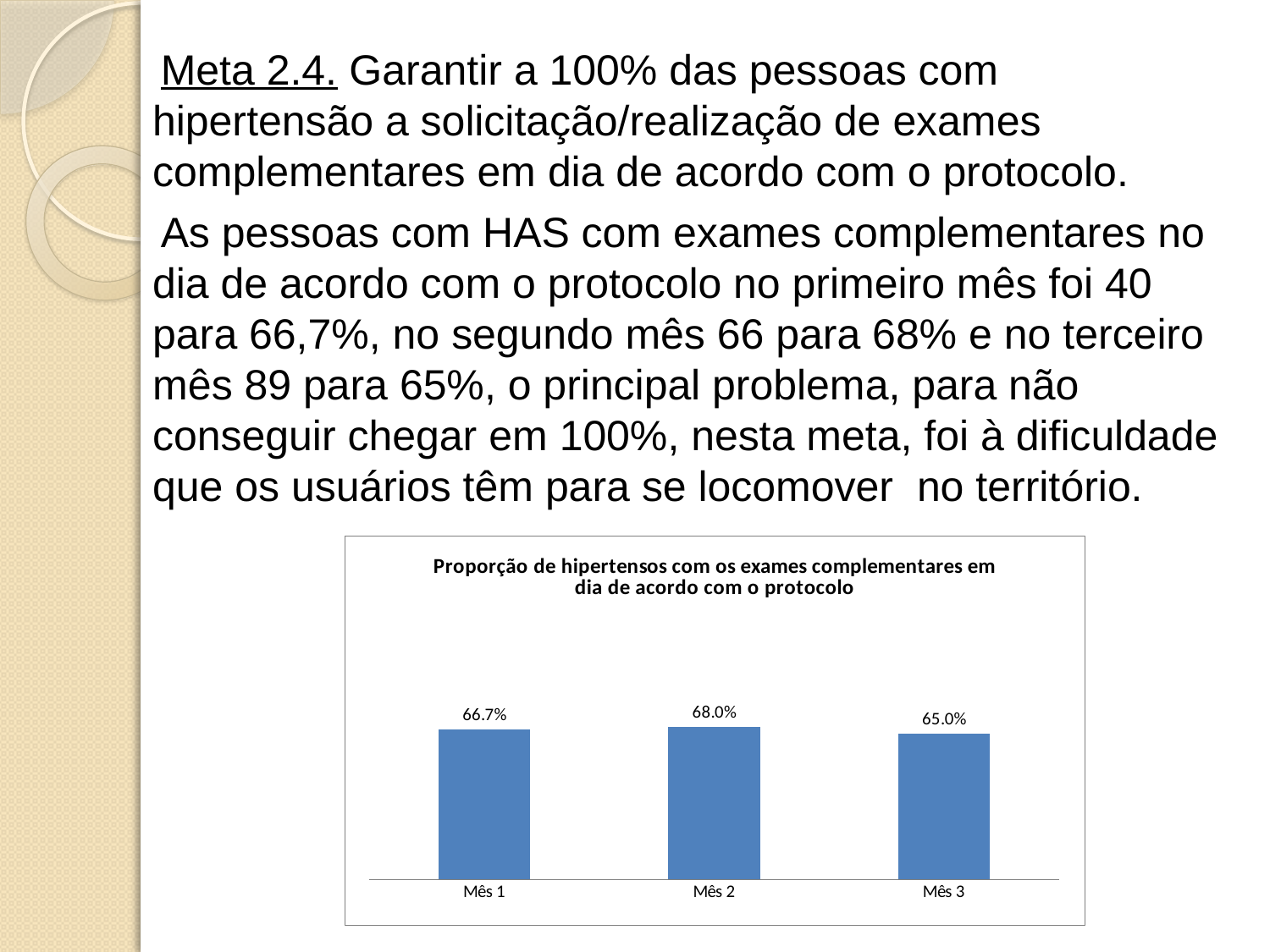
Which is larger, the value for Mês 1 or the value for Mês 2? Mês 2 Which month has the lowest value? Mês 3 What colour are the bars in the chart? Blue How many categories are shown on the x axis? 3 What is the difference between the values for Mês 2 and Mês 3? 3.0% What is the value for Mês 2? 68.0% What is the title of the chart? Proporção de hipertensos com os exames complementares em dia de acordo com o protocolo What kind of chart is shown on the slide? Bar chart Which month has the highest value? Mês 2 What is the value for Mês 1? 66.7% What is the difference between the values for Mês 1 and Mês 3? 1.7% What is the value for Mês 3? 65.0%